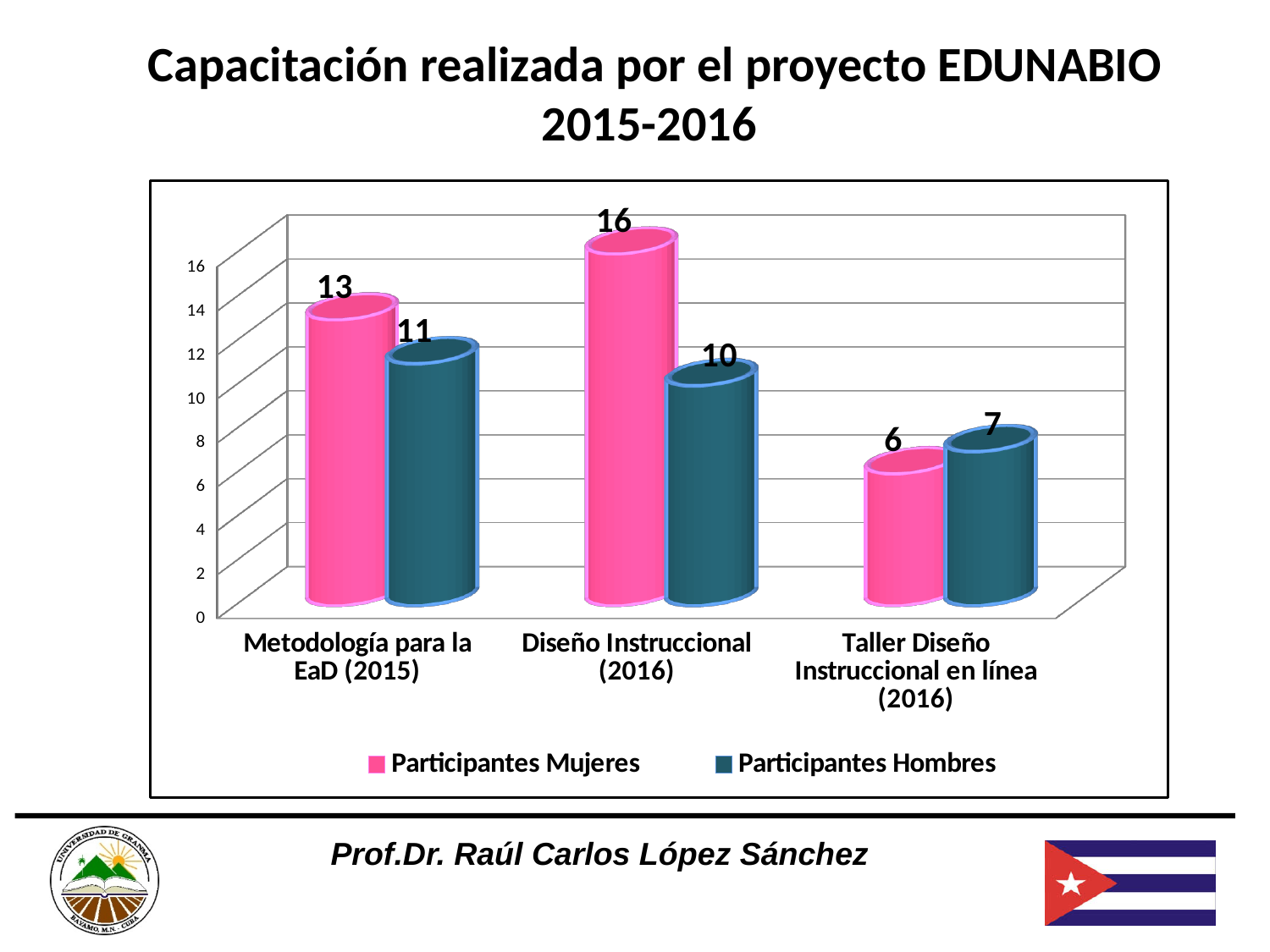
What is the value for Participantes Hombres in Metodología para la EaD (2015)? 11 What kind of chart is shown on the slide? Bar chart How many Participantes Mujeres are shown for Diseño Instruccional (2016)? 16 What is the total number of participants (Mujeres plus Hombres) for Metodología para la EaD (2015)? 24 How many series does the legend list? 2 Which category has the lowest value for Participantes Hombres? Taller Diseño Instruccional en línea (2016) In Taller Diseño Instruccional en línea (2016), which series has the larger value, Participantes Mujeres or Participantes Hombres? Participantes Hombres Which category has the highest value for Participantes Mujeres? Diseño Instruccional (2016) What is the difference between Participantes Mujeres and Participantes Hombres for Diseño Instruccional (2016)? 6 How many categories are shown on the x axis? 3 What colour represents Participantes Mujeres in the chart? Pink What is the value for Participantes Mujeres in Taller Diseño Instruccional en línea (2016)? 6